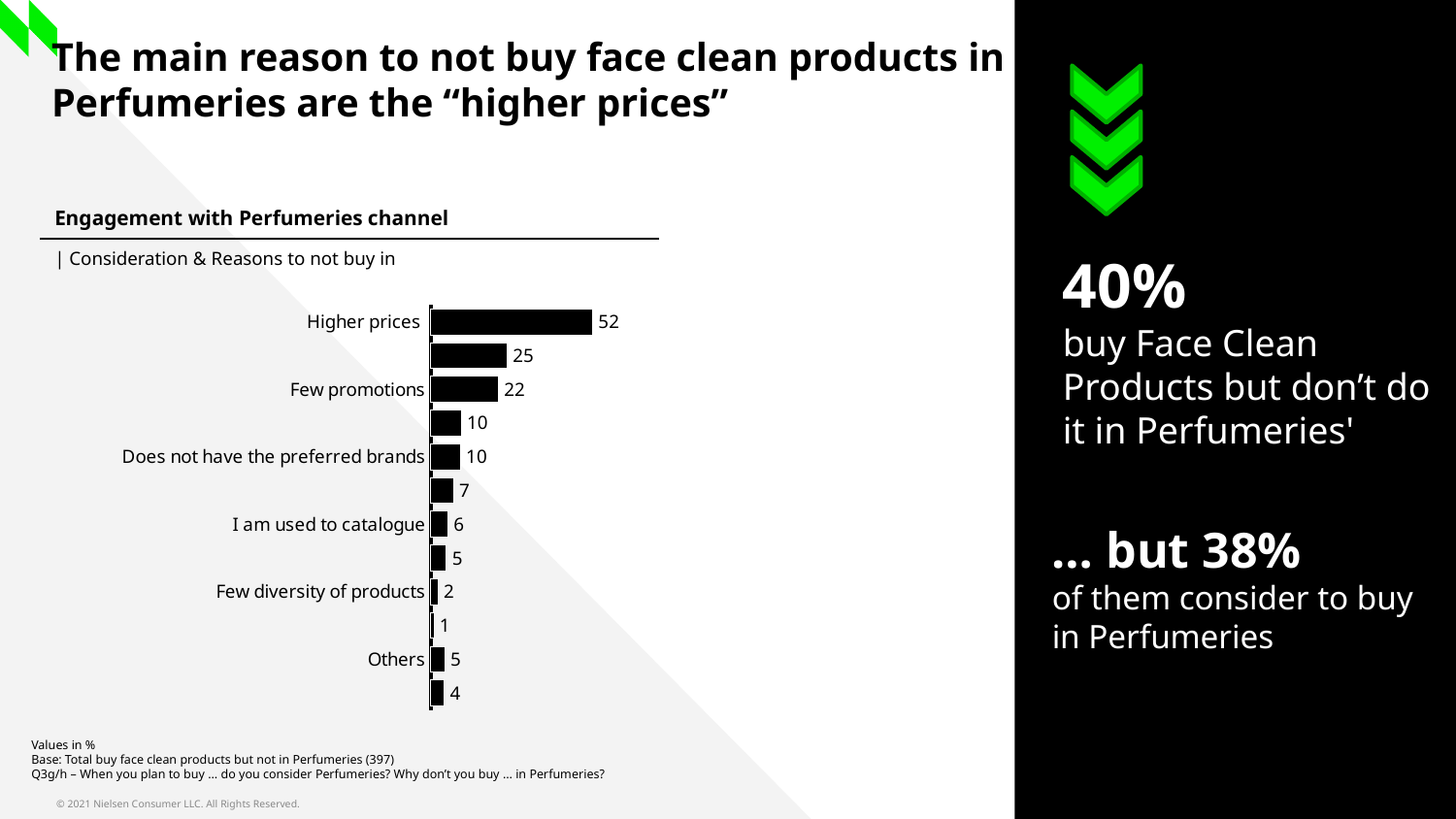
What is the value for "Few diversity of products"? 2 What is the title of the chart section on the slide? Engagement with Perfumeries channel What is the difference between the values for "Higher prices" and "Few promotions"? 30 What is the value for "Higher prices"? 52 How many bars are plotted in the chart? 12 What is the value for "I am used to catalogue"? 6 What is the value for "Does not have the preferred brands"? 10 Which is larger, the value for "Few promotions" or for "Does not have the preferred brands"? Few promotions What is the value for "Few promotions"? 22 What kind of chart is shown on the slide? Bar chart What is the value for "Others"? 5 Which category has the highest value? Higher prices